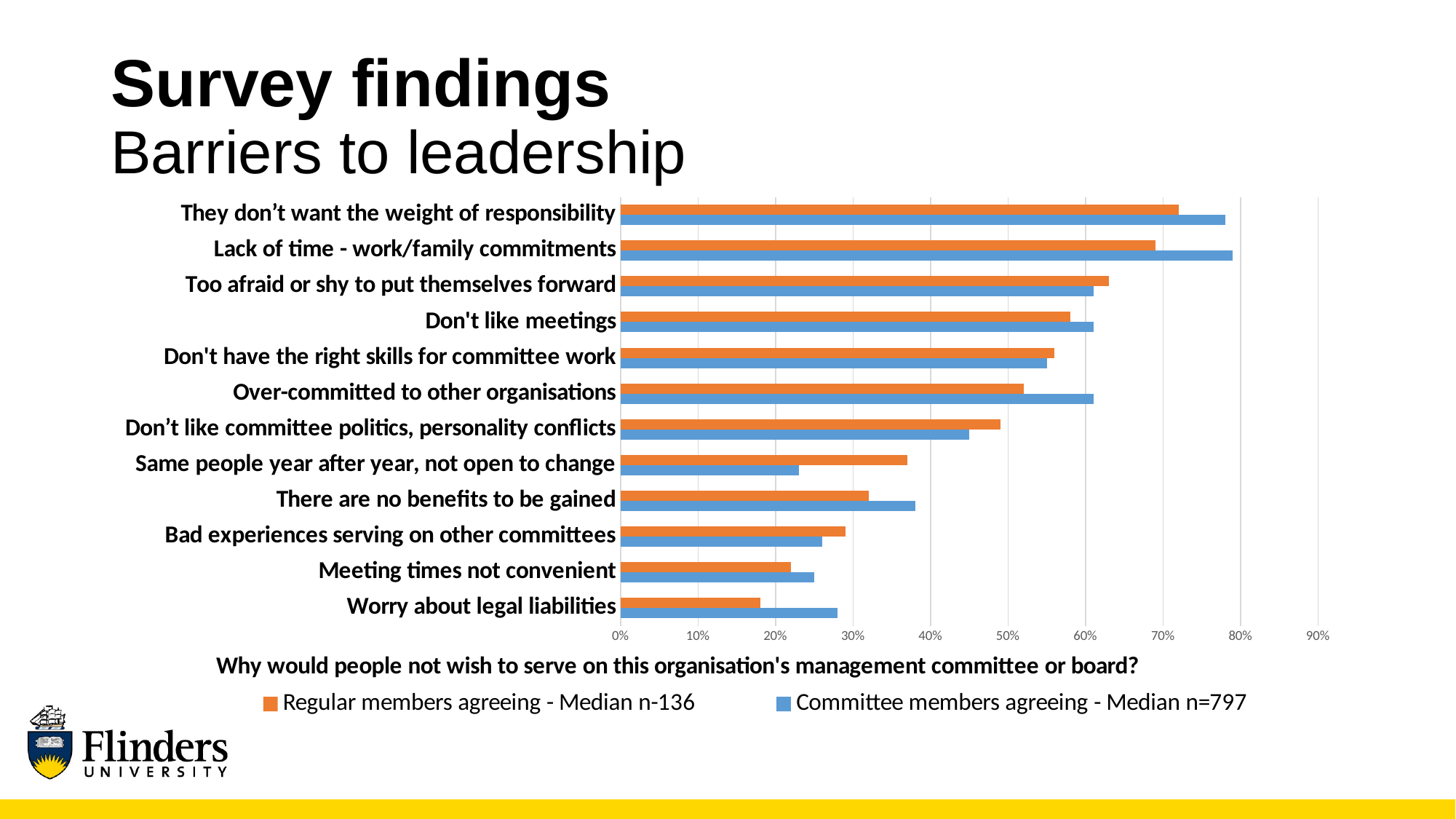
How many series does the chart legend list? 2 For 'Worry about legal liabilities', which series has the larger value: Regular members agreeing or Committee members agreeing? Committee members agreeing For 'Same people year after year, not open to change', which series has the larger value: Regular members agreeing or Committee members agreeing? Regular members agreeing What kind of chart is shown on the slide? bar chart Is the value for Committee members agreeing on 'Lack of time - work/family commitments' greater or less than 70%? greater Which barrier has the highest value for Regular members agreeing? They don't want the weight of responsibility How many barrier categories are listed on the chart? 12 Is the value for Committee members agreeing on 'Same people year after year, not open to change' greater or less than 30%? less Is the value for Regular members agreeing on 'Over-committed to other organisations' greater or less than 40%? greater What colour represents the 'Committee members agreeing - Median n=797' series? blue Which barrier has the lowest value for Regular members agreeing? Worry about legal liabilities